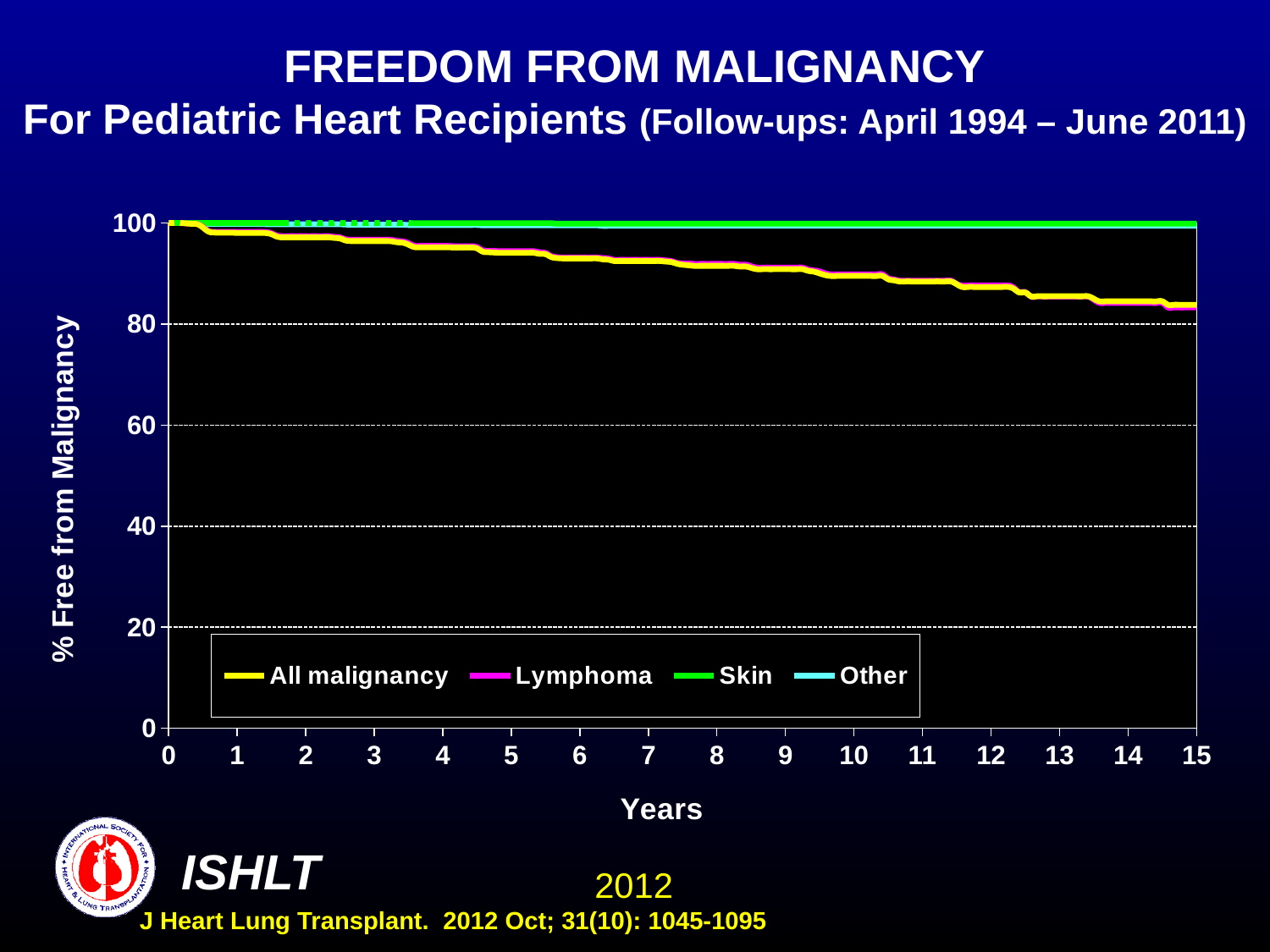
How many series does the legend list? 4 Is the value for Lymphoma at 10 years greater or less than 80? greater Does the All malignancy curve rise or fall as years increase? fall What is the maximum year shown on the x axis? 15 What is the label of the y axis? % Free from Malignancy Is the value for Skin at 15 years greater or less than 80? greater What kind of chart is shown on the slide? line chart What colour is the All malignancy line in the legend? yellow Is the value for All malignancy at 15 years greater or less than 80? greater What is the value of the All malignancy curve at year 0? 100 Which series has the lowest value at 15 years: Skin or Lymphoma? Lymphoma At 15 years, which is higher: Skin or All malignancy? Skin